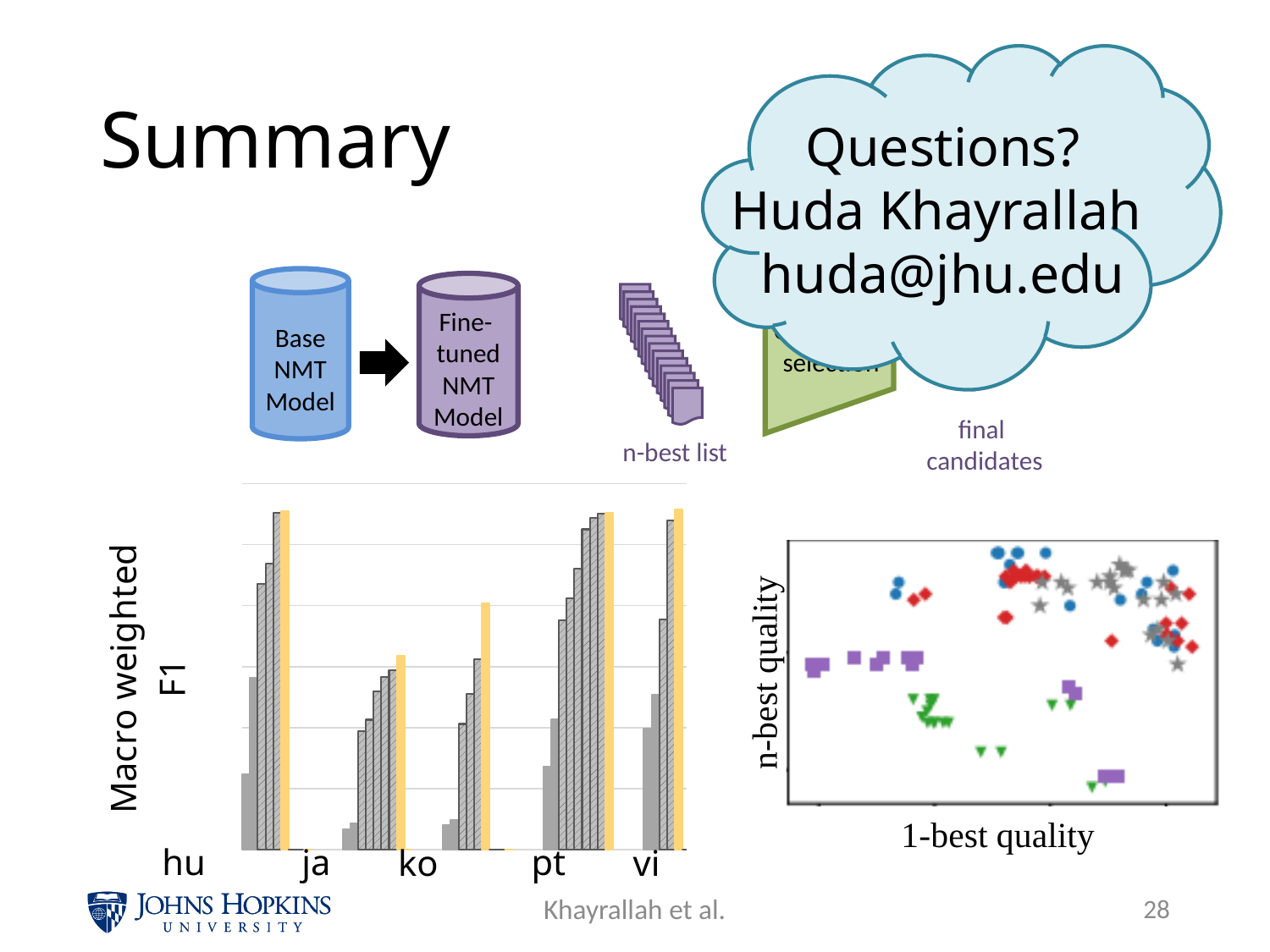
In the scatter plot on the right of the slide, what is the label of the y axis? n-best quality In the 'Macro weighted F1' bar chart, which language category has the lowest bars overall? ja In the scatter plot on the right of the slide, what is the label of the x axis? 1-best quality In the 'Macro weighted F1' bar chart, how many language categories are shown on the x axis? 5 In the 'Macro weighted F1' bar chart, what colour is the rightmost bar in each language group? yellow What kind of chart is the chart on the right of the slide, with axes '1-best quality' and 'n-best quality'? scatter plot What kind of chart is the chart on the left of the slide, labelled 'Macro weighted F1'? bar chart